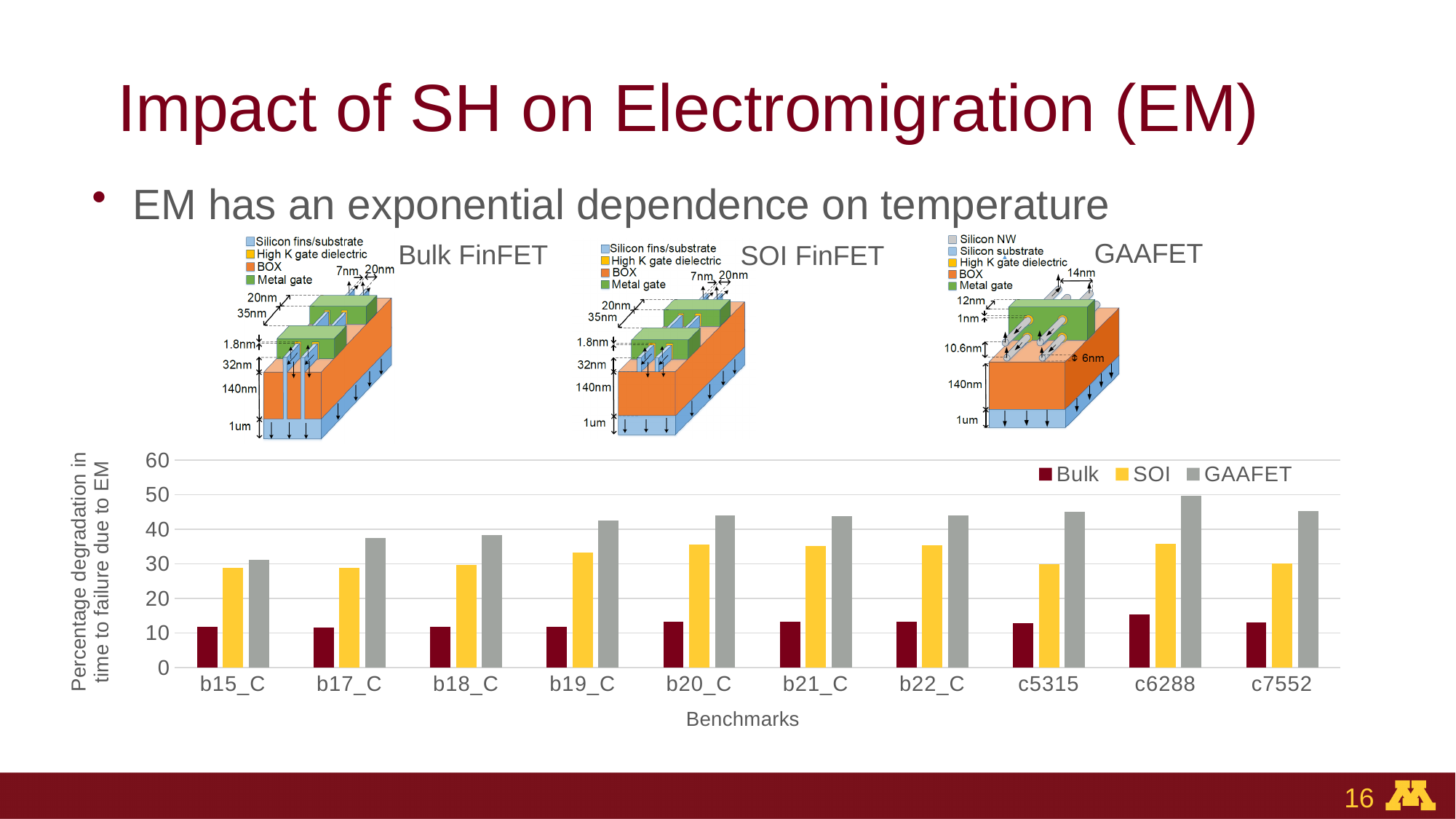
Is the GAAFET value for b15_C greater or less than 40? less What is the title of the x axis of the chart? Benchmarks How many series does the chart legend list? 3 Which benchmark has the lowest GAAFET value? b15_C What kind of chart is shown on the slide? bar chart Is the SOI value for b19_C greater or less than 30? greater How many benchmarks are shown on the x axis of the chart? 10 For b22_C, which is larger: the SOI value or the GAAFET value? GAAFET Which benchmark has the highest Bulk value? c6288 Which benchmark has the highest GAAFET value? c6288 Is the Bulk value for b15_C greater or less than 20? less